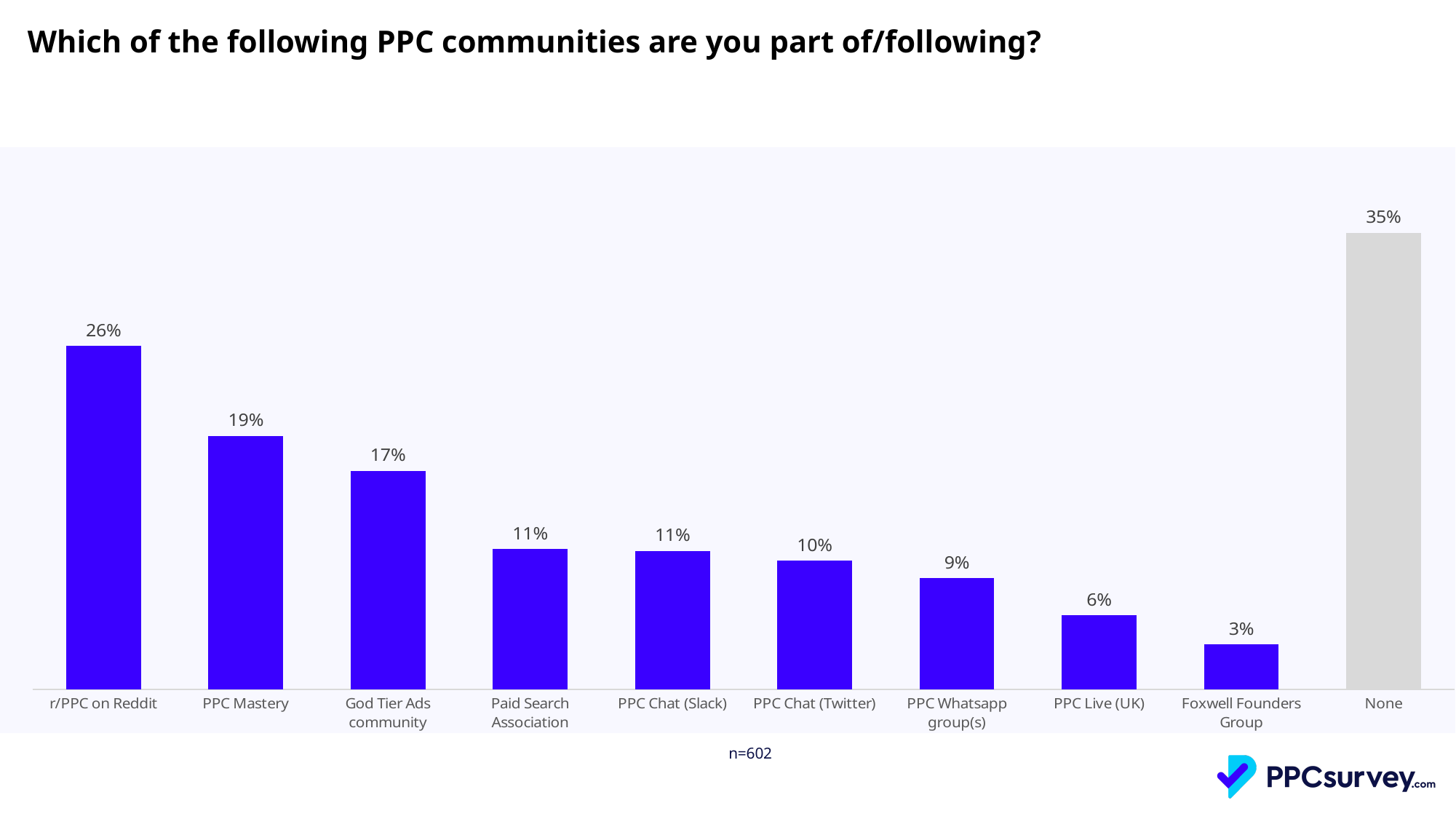
What is the value for PPC Chat (Twitter)? 10% What percentage is shown for the Foxwell Founders Group? 3% What is the difference between the values for r/PPC on Reddit and PPC Mastery? 7% How many categories are shown on the chart? 10 What is the value shown for PPC Mastery? 19% Which category has the lowest value on the chart? Foxwell Founders Group What is the difference between the values for None and r/PPC on Reddit? 9% What kind of chart is shown on the slide? Bar chart Which is larger, the value for God Tier Ads community or the value for PPC Whatsapp group(s)? God Tier Ads community What percentage of respondents are part of r/PPC on Reddit? 26% Which category has the highest value on the chart? None What sample size (n) is stated below the chart? n=602